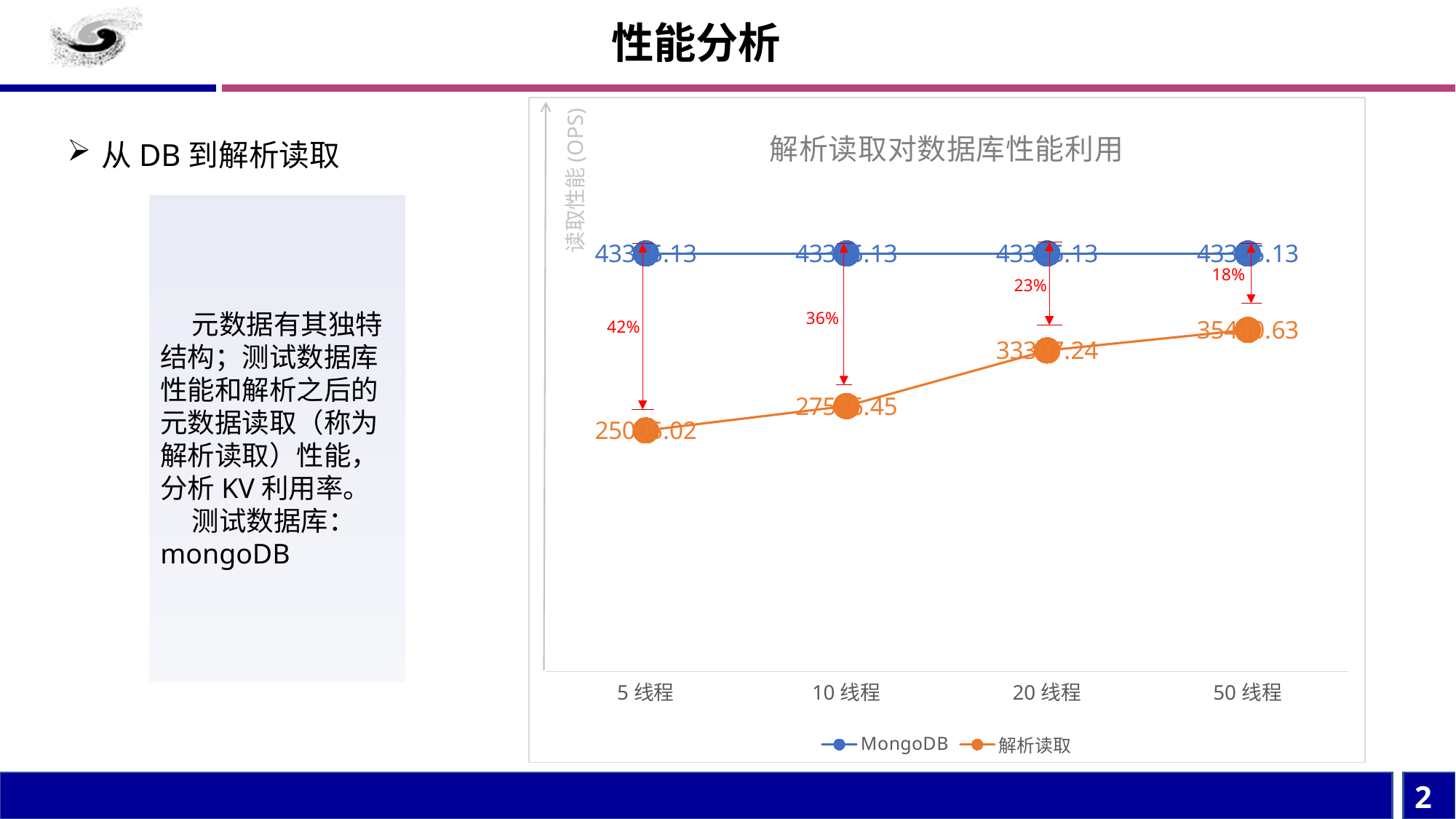
At 5 线程, which series has the higher value, MongoDB or 解析读取? MongoDB Does the MongoDB series rise, fall, or stay flat across the thread counts? stay flat How many thread-count categories are shown on the x axis? 4 At which thread count is the 解析读取 value highest? 50 线程 How many series does the legend list? 2 What percentage gap is annotated between the two series at 50 线程? 18% Does the 解析读取 series rise or fall as the thread count increases from 5 线程 to 50 线程? rise Which series is plotted in orange? 解析读取 What percentage gap is annotated between the two series at 5 线程? 42% At which thread count is the 解析读取 value lowest? 5 线程 What kind of chart is shown on the slide? line chart What is the title of the chart? 解析读取对数据库性能利用